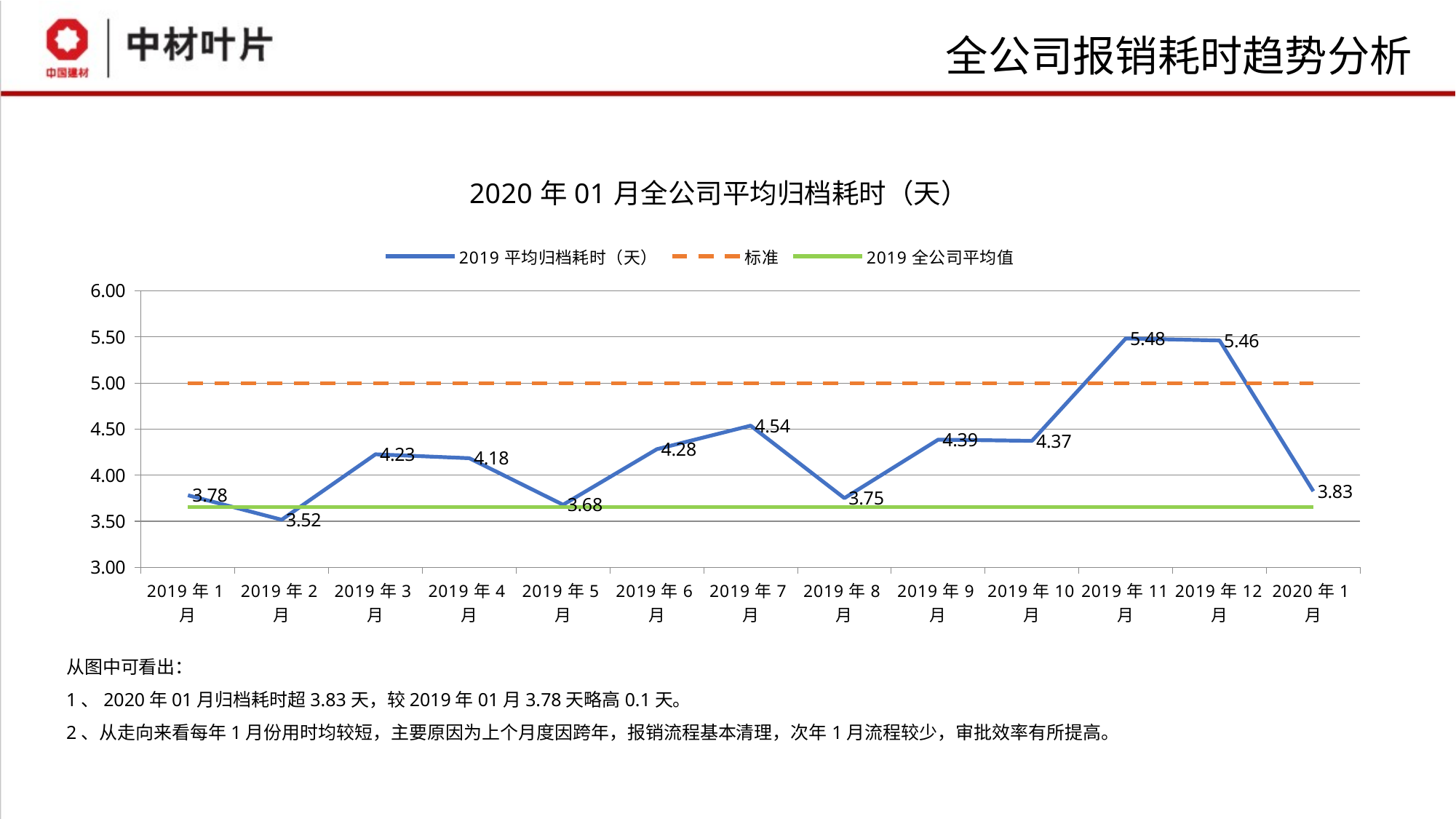
What is the chart's title? 2020年01月全公司平均归档耗时（天） What is the difference between the values for 2019年11月 and 2019年12月? 0.02 Which is larger, the value for 2019年3月 or 2019年4月? 2019年3月 Which month has the highest value on the 2019 平均归档耗时（天） line? 2019年11月 Which month has the lowest value on the 2019 平均归档耗时（天） line? 2019年2月 Is the 标准 (dashed) line greater or less than 4.50? greater What is the value for 2020年1月? 3.83 What is the value for 2019年7月? 4.54 How many series does the legend list? 3 How many data points are plotted on the 2019 平均归档耗时（天） line? 13 What is the value for 2019年1月? 3.78 What type of chart is shown on the slide? line chart